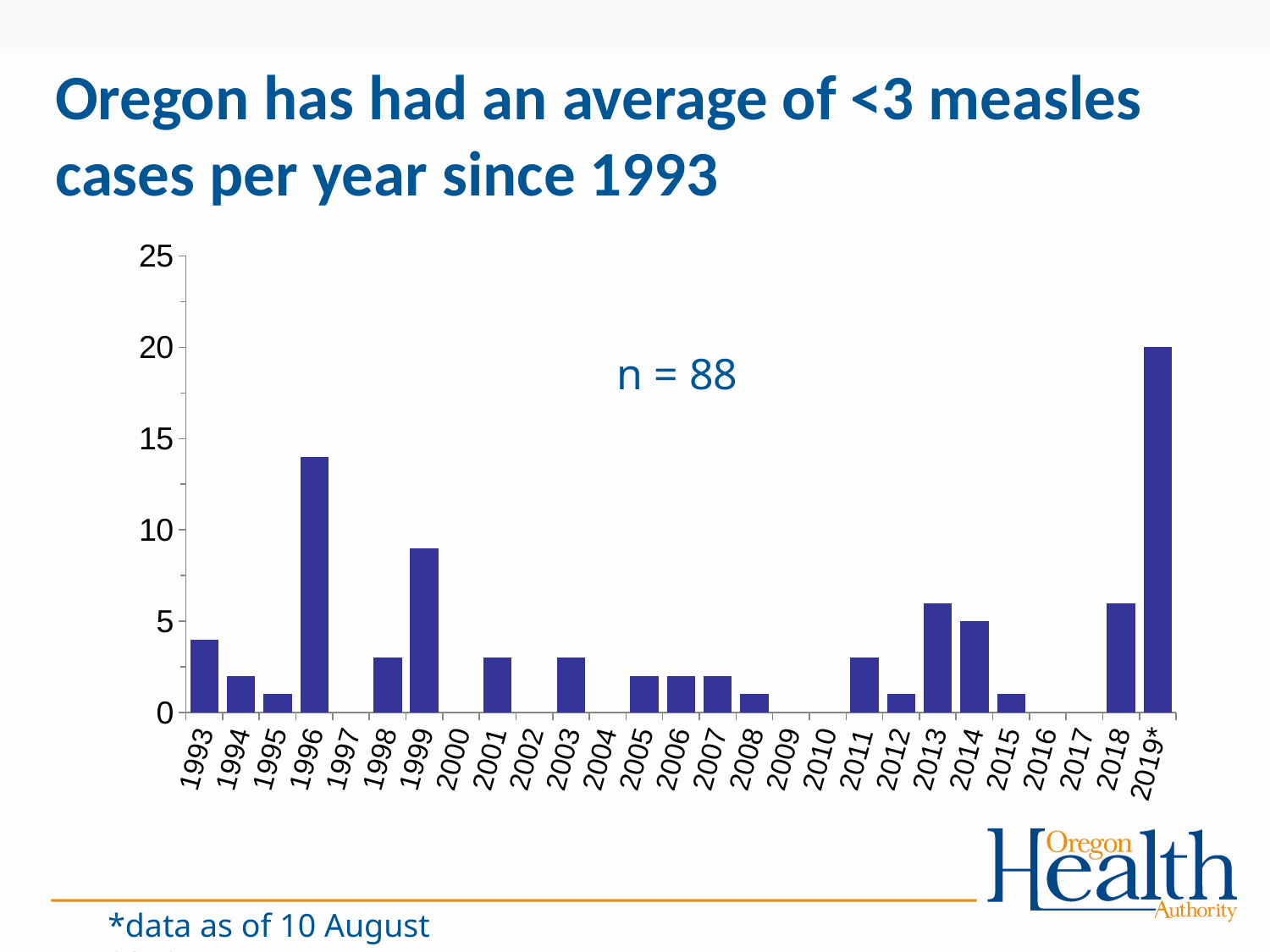
What is the value for 2014 in the chart? 5 Is the value for 2018 greater or less than 5? greater How many years on the chart have no bar (zero cases)? 8 Is the value for 1993 greater or less than 5? less Is the value for 1996 greater or less than 10? greater What total sample size (n) is annotated on the chart? n = 88 Which year has the highest number of measles cases in the chart? 2019* How many years are shown on the x axis of the chart? 27 What kind of chart is shown on the slide? bar chart Which year has more cases, 1996 or 1999? 1996 What is the value for 2019* in the chart? 20